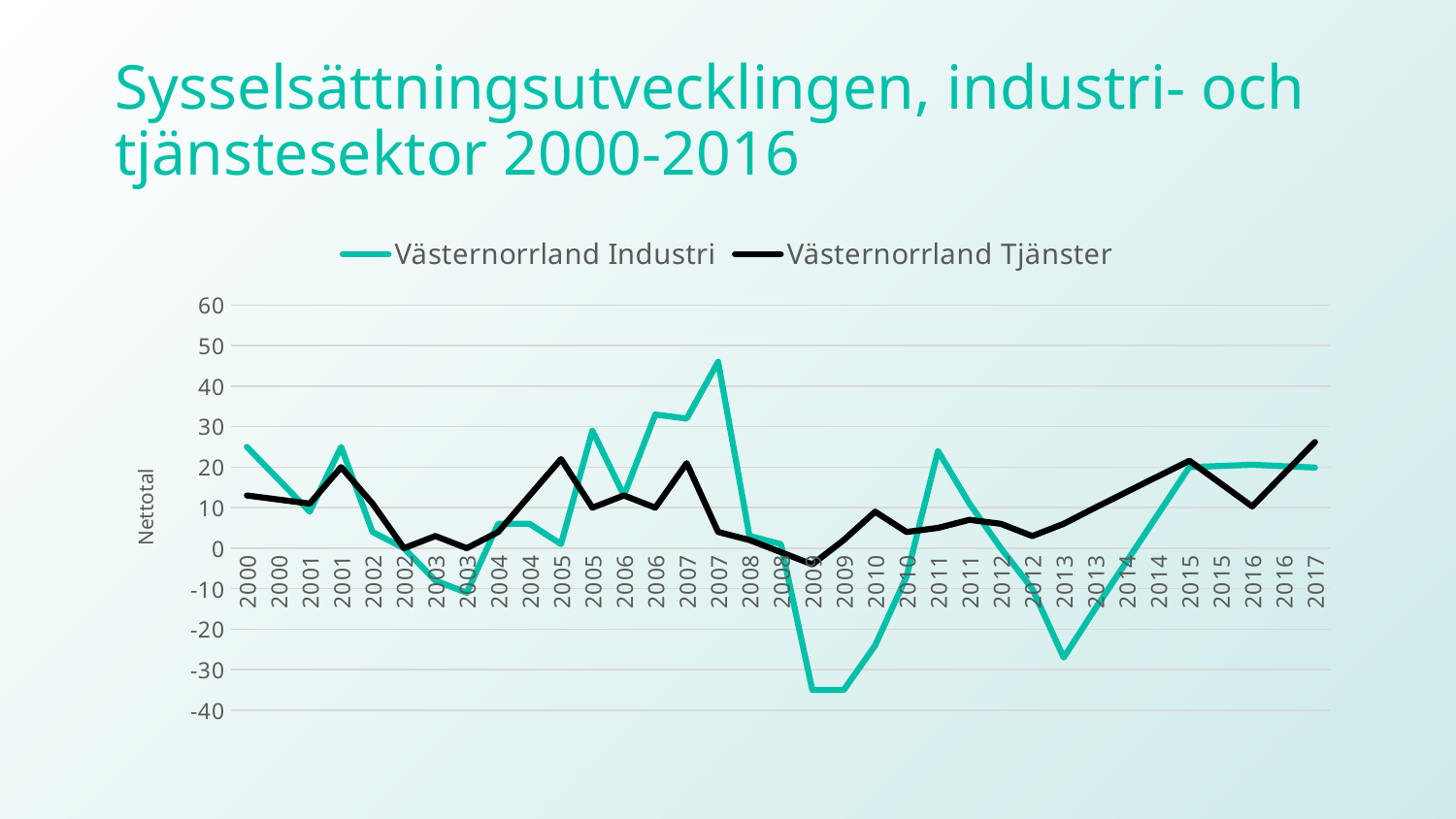
Is the value of Västernorrland Tjänster at 2017 greater or less than 20? greater Is the lowest value of the Västernorrland Industri line (in 2009) greater or less than -30? less What are the two series named in the legend? Västernorrland Industri and Västernorrland Tjänster What kind of chart is shown on the slide? line chart At 2009, which series has the higher value, Västernorrland Industri or Västernorrland Tjänster? Västernorrland Tjänster What is the label on the vertical axis? Nettotal Does the Västernorrland Tjänster line rise or fall between 2013 and 2015? rise Is the value of Västernorrland Industri at the second 2013 point greater or less than -20? greater How many series does the legend list? 2 In which year does the Västernorrland Industri line reach its lowest point? 2009 In which year does the Västernorrland Industri line reach its highest point? 2007